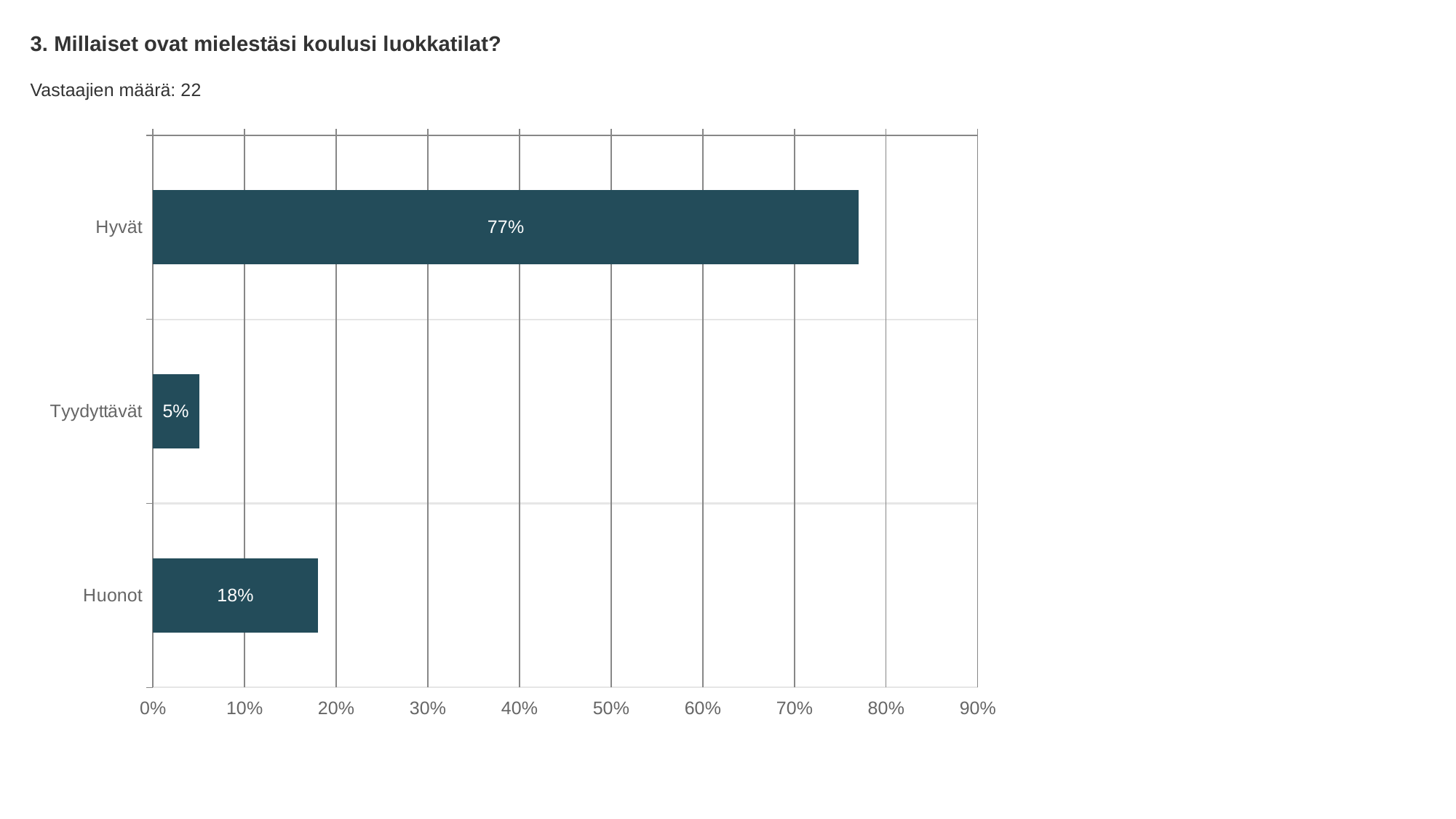
How many respondents (Vastaajien määrä) does the slide report? 22 Is the value for "Hyvät" greater or less than 70%? greater What is the difference in percentage points between "Huonot" and "Tyydyttävät"? 13 What percentage of respondents answered "Huonot"? 18% What kind of chart is shown on the slide? Bar chart What is the difference in percentage points between "Hyvät" and "Huonot"? 59 How many categories are shown in the chart? 3 What percentage of respondents answered "Tyydyttävät"? 5% Which category has the lowest percentage? Tyydyttävät Which is larger, the value for "Huonot" or the value for "Tyydyttävät"? Huonot Which category has the highest percentage? Hyvät What percentage of respondents answered "Hyvät"? 77%